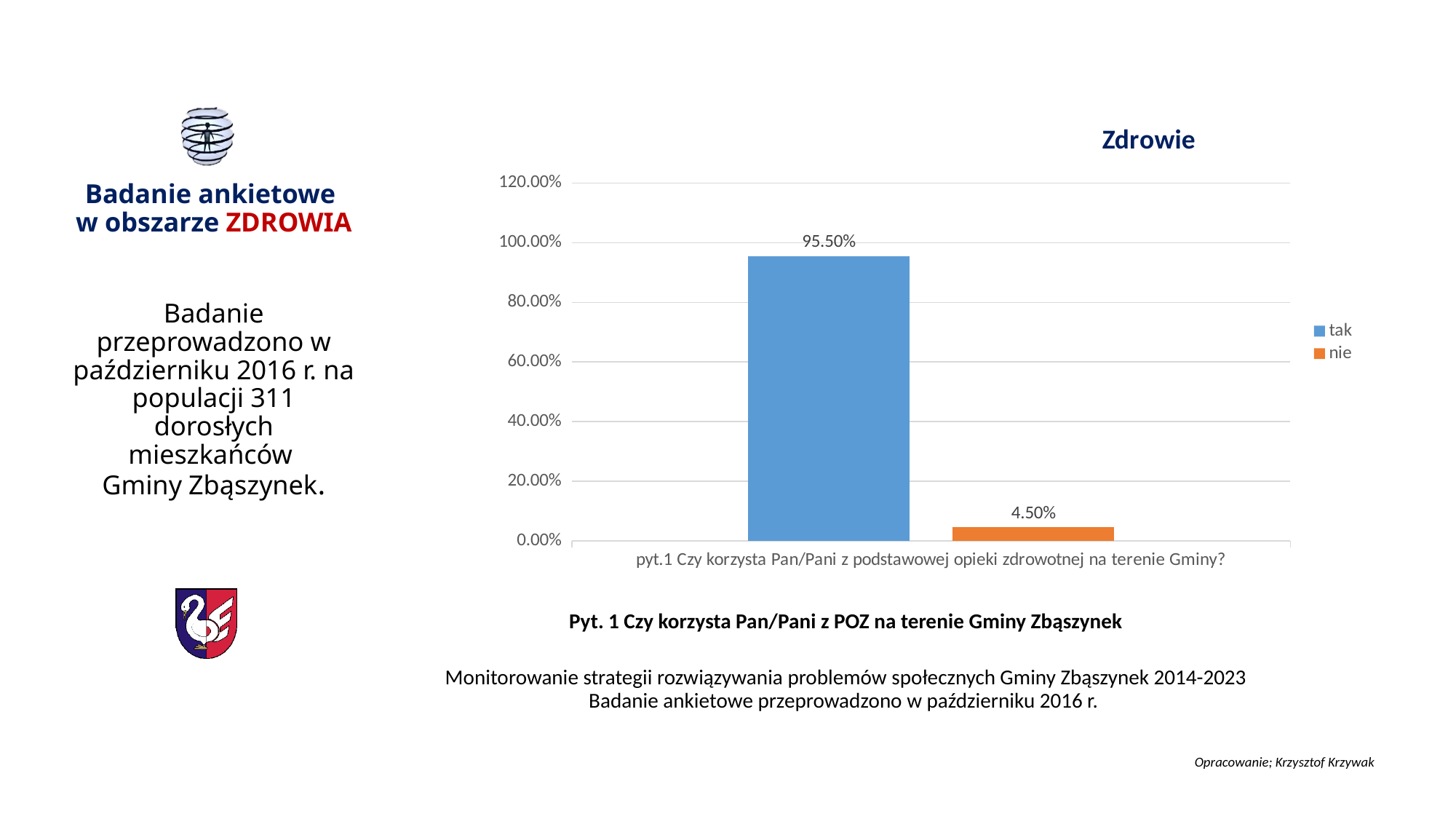
Is the value for "tak" greater or less than 80.00%? greater What is the difference between the values for "tak" and "nie"? 91.00% What is the value for "nie" in the chart? 4.50% Is the value for "nie" greater or less than 20.00%? less What is the title of the chart? Zdrowie What colour is the bar for "nie"? orange Which is larger, the value for "tak" or the value for "nie"? tak Which series has the highest value in the chart? tak What kind of chart is shown on the slide? bar chart What is the value for "tak" in the chart? 95.50% How many series does the legend list? 2 Which series has the lowest value in the chart? nie